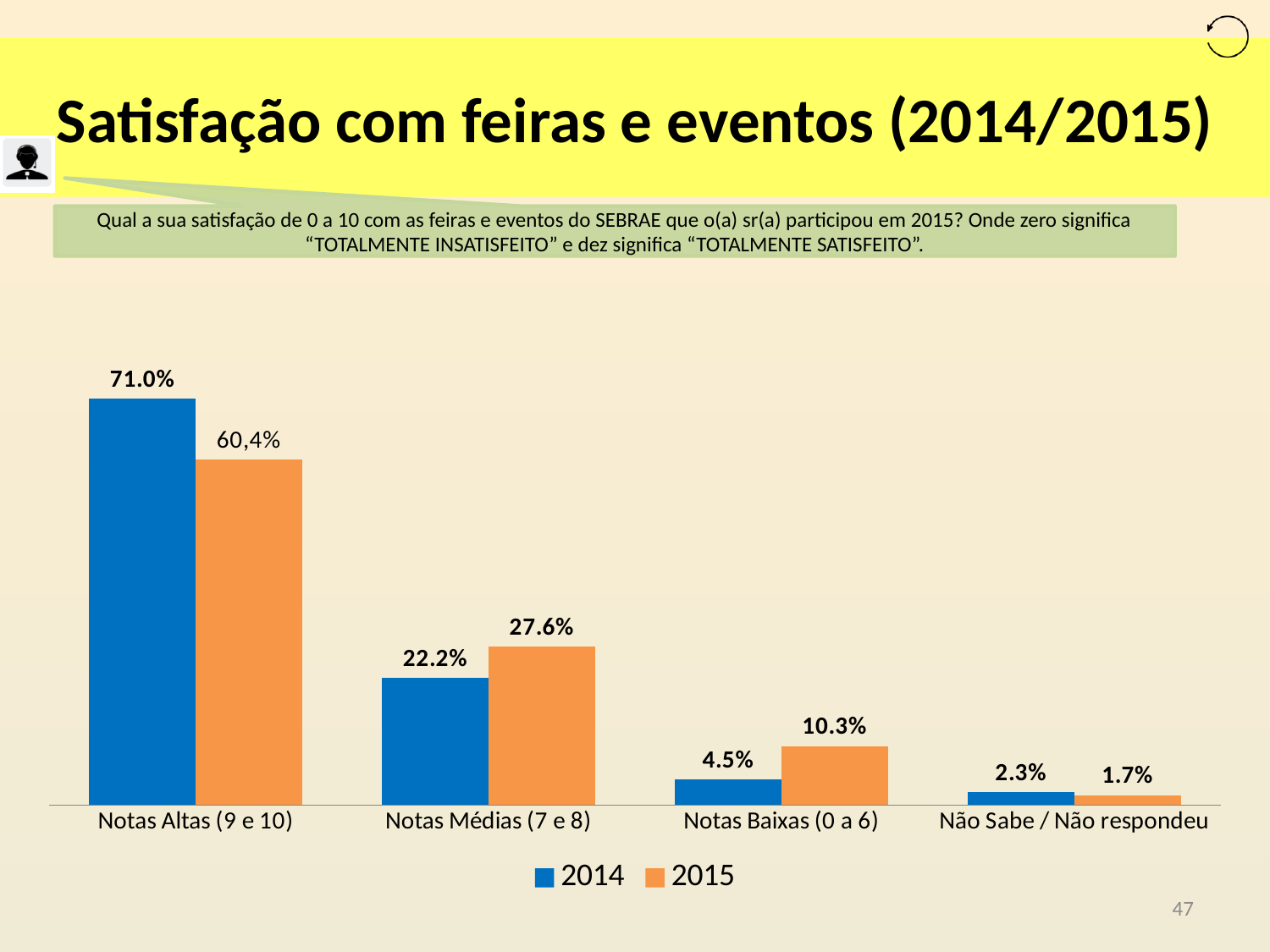
What is the difference between the 2015 and 2014 values for Notas Médias (7 e 8)? 5.4% What is the 2015 value for Notas Médias (7 e 8)? 27.6% Which category has the lowest 2015 value? Não Sabe / Não respondeu How many categories are shown on the x axis? 4 What is the 2014 value for Notas Baixas (0 a 6)? 4.5% Which is larger for Notas Baixas (0 a 6): the 2014 value or the 2015 value? 2015 What type of chart is shown on the slide? bar chart What is the 2015 value for Notas Altas (9 e 10)? 60,4% Which colour represents the 2015 series in the legend? orange How many series does the legend list? 2 What is the 2014 value for Notas Altas (9 e 10)? 71.0% Which category has the highest 2014 value? Notas Altas (9 e 10)